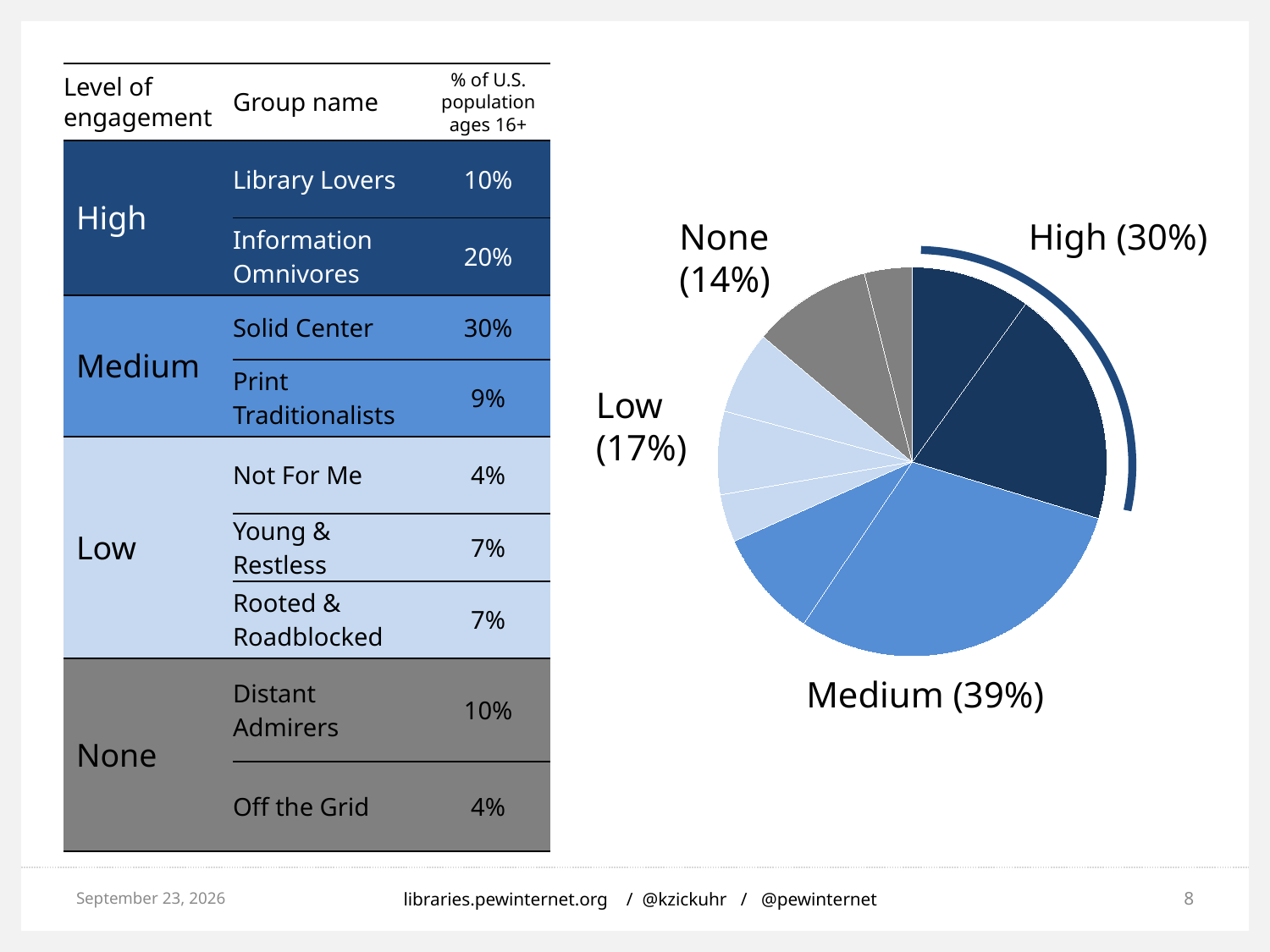
Which engagement level has the largest share of the pie chart? Medium What type of chart is shown on the slide? pie chart What share of the pie chart is labeled Low? 17% What share of the pie chart is labeled High? 30% What share of the pie chart is labeled None? 14% Which is larger in the pie chart, the Low share or the None share? Low What colour is the None section of the pie chart? gray Which engagement level has the smallest share of the pie chart? None What is the difference in percentage points between the Medium and High shares of the pie chart? 9 What is the combined share of the High and Medium sections of the pie chart? 69% How many engagement levels are labeled around the pie chart? 4